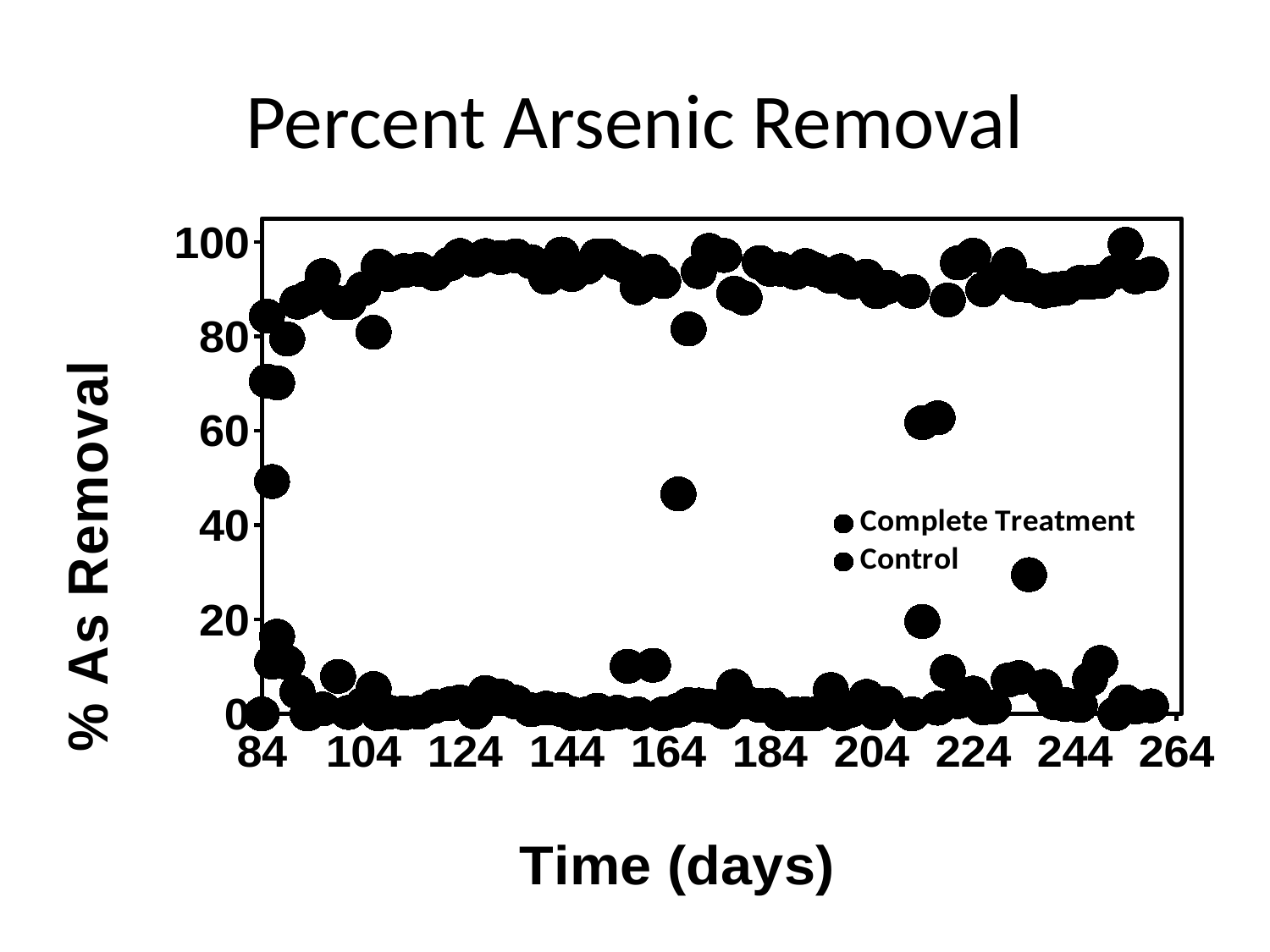
Which series has higher % As Removal values overall, Complete Treatment or Control? Complete Treatment Are most of the Complete Treatment values greater or less than 80? greater Which series contains the highest plotted value on the chart? Complete Treatment Is the highest Control value greater or less than 20? greater What is the title of the chart? Percent Arsenic Removal Are most of the Control values greater or less than 20? less How many series does the legend list? 2 What kind of chart is shown on the slide? Scatter chart What is the label of the x axis? Time (days)